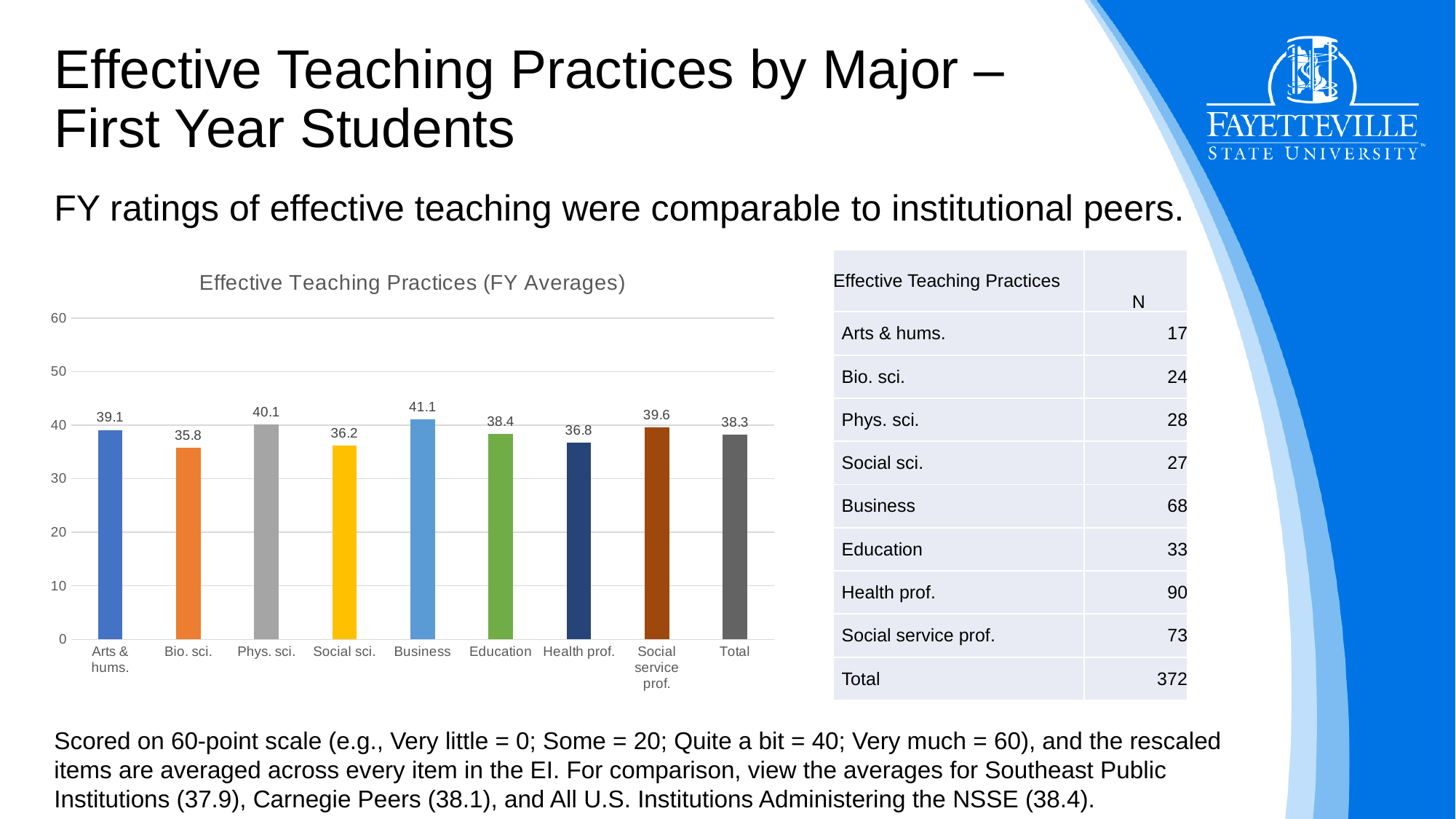
Is the value for Health prof. greater or less than 40? less Which category has the lowest value in the chart? Bio. sci. What is the value for Bio. sci. in the chart? 35.8 What is the difference between the values for Business and Bio. sci.? 5.3 Which is larger, the value for Arts & hums. or the value for Education? Arts & hums. What is the difference between the values for Phys. sci. and Social sci.? 3.9 What is the value for Social service prof. in the chart? 39.6 What is the value for Business in the Effective Teaching Practices (FY Averages) chart? 41.1 What is the value for Total in the chart? 38.3 How many categories are shown on the x axis of the chart? 9 What kind of chart is shown on the slide? bar chart Which category has the highest value in the chart? Business